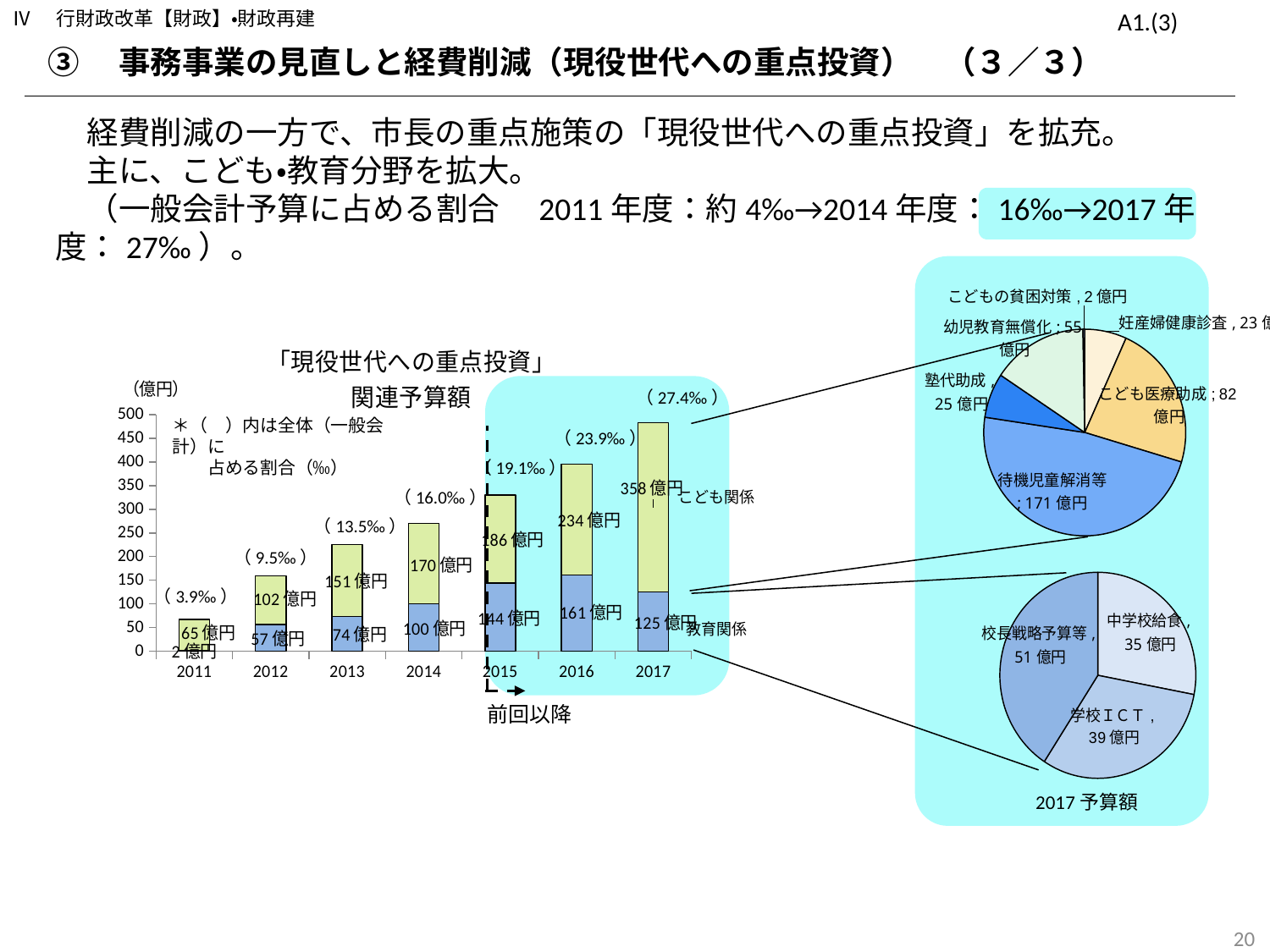
What kind of chart is 「現役世代への重点投資」関連予算額? stacked bar chart In the upper pie chart on the right (こども関係, 2017 予算額), what is the value for 待機児童解消等? 171 億円 In the bar chart 「現役世代への重点投資」関連予算額, which year has the lowest value for 教育関係? 2011 In the lower pie chart on the right (教育関係, 2017 予算額), which category has the largest value? 校長戦略予算等 In the bar chart 「現役世代への重点投資」関連予算額, what is the total of the stacked bar for 2016? 395 億円 In the bar chart 「現役世代への重点投資」関連予算額, what is the difference between こども関係 in 2017 and こども関係 in 2016? 124 億円 In the bar chart 「現役世代への重点投資」関連予算額, does the total stacked value rise or fall from 2011 to 2017? rise In the bar chart 「現役世代への重点投資」関連予算額, what is the value for こども関係 in 2017? 358 億円 In the bar chart 「現役世代への重点投資」関連予算額, how many years are shown on the x axis? 7 In the bar chart 「現役世代への重点投資」関連予算額, what share of the general account budget (‰) is shown above the 2015 bar? 19.1‰ In the bar chart 「現役世代への重点投資」関連予算額, which is larger: 教育関係 in 2016 or 教育関係 in 2017? 2016 In the bar chart 「現役世代への重点投資」関連予算額, what is the value for 教育関係 in 2014? 100 億円